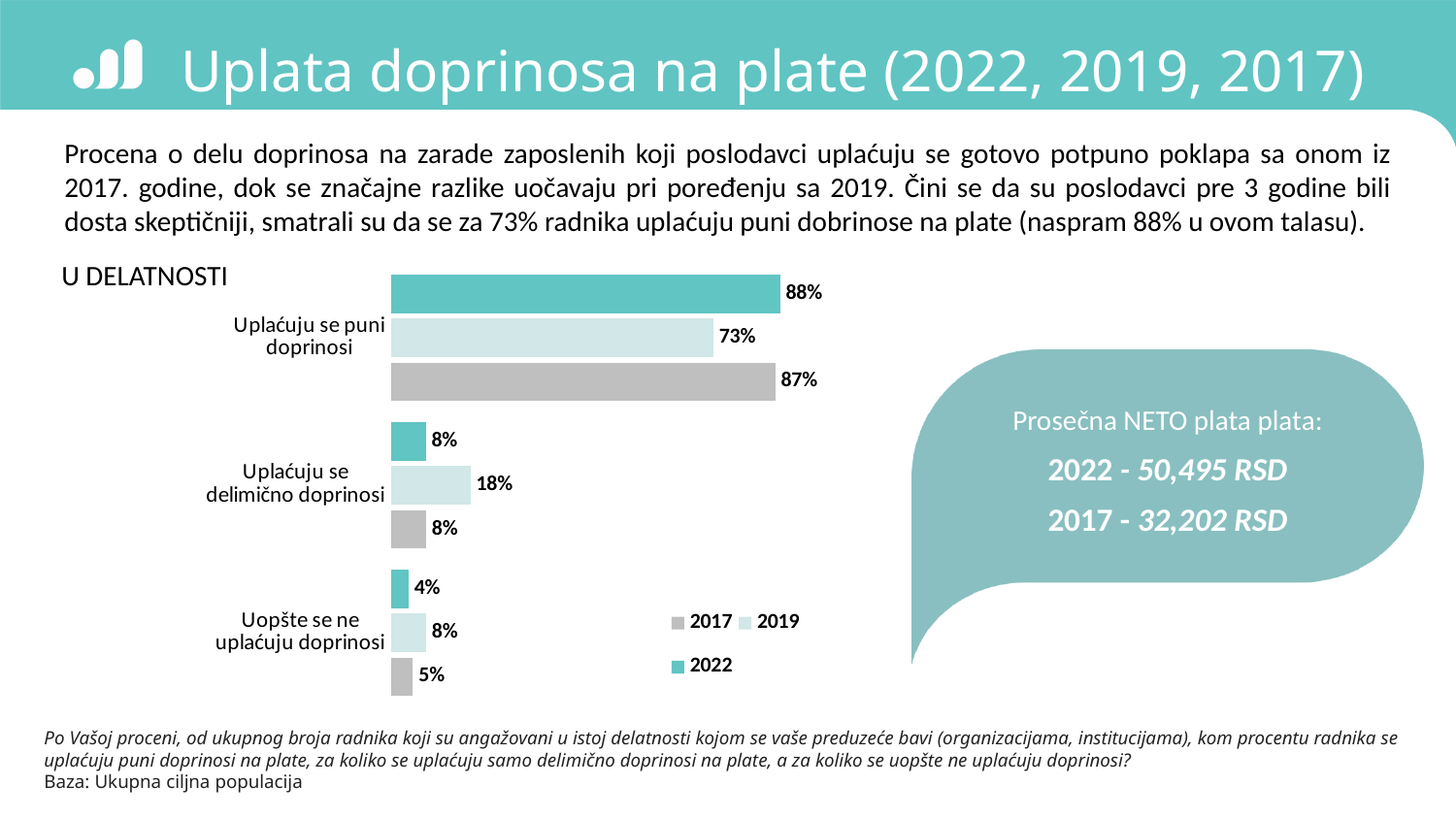
What is the difference between the 2019 and 2022 values for 'Uplaćuju se delimično doprinosi'? 10% Which is larger: the 2022 value or the 2017 value for 'Uplaćuju se puni doprinosi'? 2022 How many categories are shown on the chart? 3 What is the 2019 value for 'Uplaćuju se delimično doprinosi'? 18% What kind of chart is shown on the slide? Bar chart Which year has the lowest value for 'Uplaćuju se puni doprinosi'? 2019 What is the 2017 value for 'Uopšte se ne uplaćuju doprinosi'? 5% How many series does the legend list? 3 Which years are listed in the chart legend? 2017, 2019, 2022 What is the difference between the 2022 and 2019 values for 'Uplaćuju se puni doprinosi'? 15% Which year has the highest value for 'Uopšte se ne uplaćuju doprinosi'? 2019 What percentage of workers were estimated to have full contributions paid (Uplaćuju se puni doprinosi) in 2022? 88%